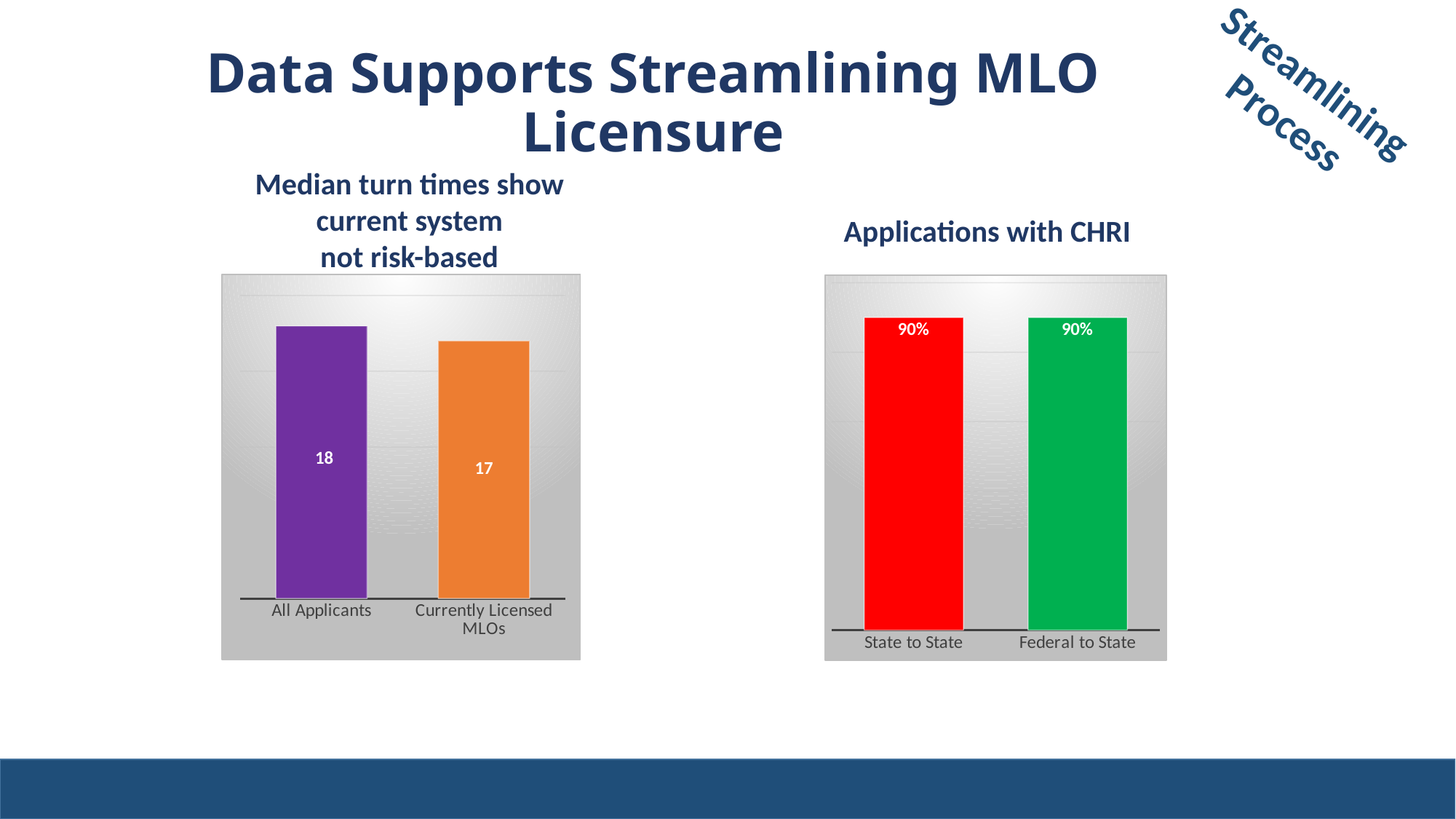
What kind of chart is the 'Median turn times show current system not risk-based' chart? bar chart In the 'Median turn times show current system not risk-based' chart, what colour is the All Applicants bar? purple In the 'Applications with CHRI' chart, what colour is the State to State bar? red In the 'Median turn times show current system not risk-based' chart, how many categories are plotted? 2 In the 'Median turn times show current system not risk-based' chart, what is the value for All Applicants? 18 In the 'Applications with CHRI' chart, what is the difference between the State to State and Federal to State values? 0% In the 'Median turn times show current system not risk-based' chart, what is the value for Currently Licensed MLOs? 17 In the 'Median turn times show current system not risk-based' chart, which category has the highest value? All Applicants In the 'Applications with CHRI' chart, what is the value for State to State? 90% In the 'Median turn times show current system not risk-based' chart, what is the difference between the All Applicants and Currently Licensed MLOs values? 1 In the 'Applications with CHRI' chart, how many categories are plotted? 2 In the 'Applications with CHRI' chart, what is the value for Federal to State? 90%